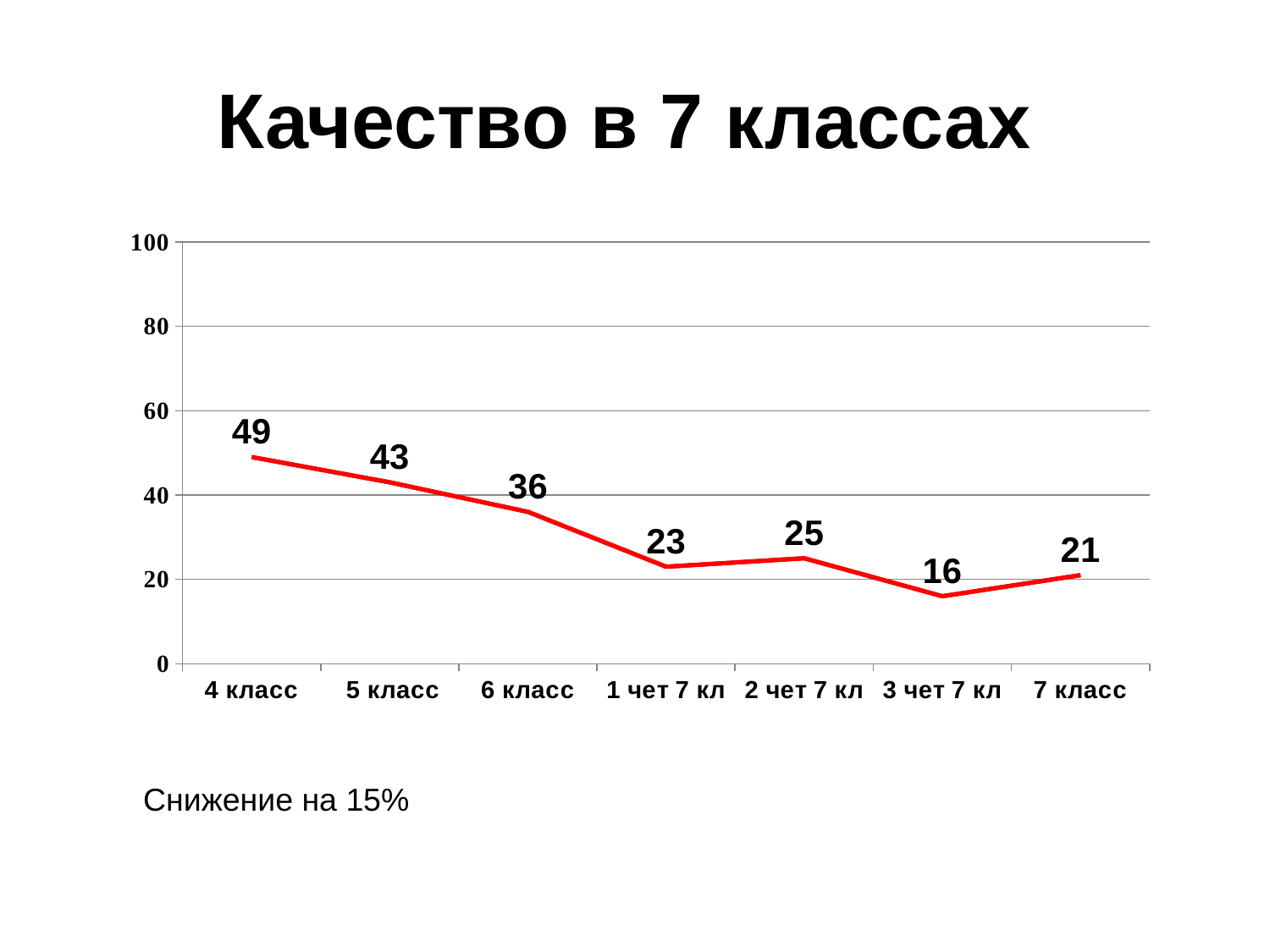
What is the value for 7 класс? 21 How many categories are plotted on the x axis? 7 Which category has the highest value? 4 класс What is the value for 6 класс? 36 What is the value for 2 чет 7 кл? 25 Which category has the lowest value? 3 чет 7 кл Which is larger, the value for 1 чет 7 кл or the value for 2 чет 7 кл? 2 чет 7 кл Is the value for 5 класс greater or less than 40? greater What is the value for 4 класс? 49 What kind of chart is shown on the slide? line chart Do the values generally rise or fall from 4 класс to 7 класс? fall What is the difference between the values for 4 класс and 7 класс? 28